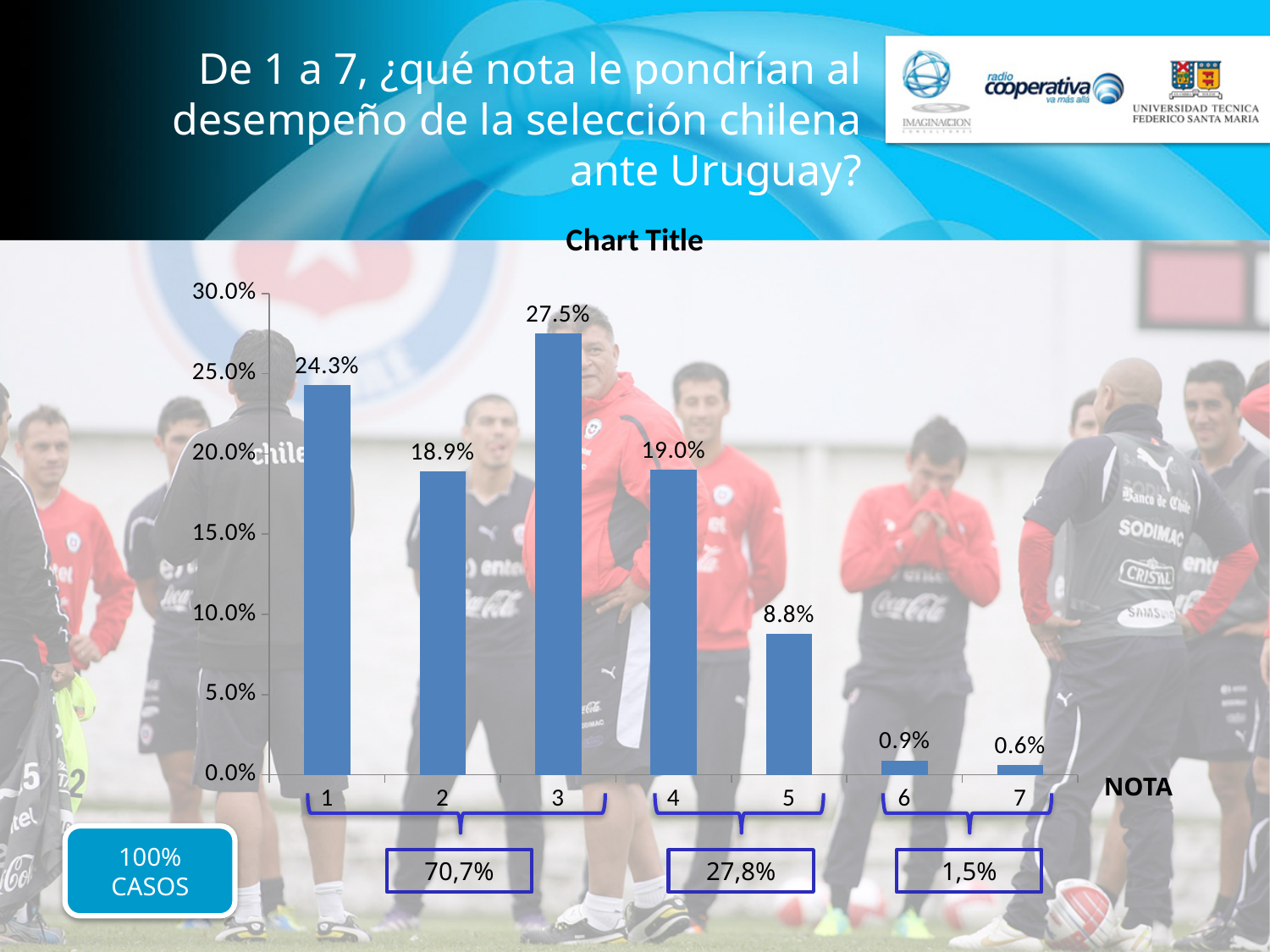
What is the value shown for nota 7? 0.6% What percentage of respondents gave a nota of 1? 24.3% What kind of chart is shown on the slide? bar chart How many nota categories are shown on the x axis? 7 What is the combined percentage shown in the box below notas 4 and 5? 27,8% Which nota has the highest percentage? 3 What is the value shown for nota 5? 8.8% What percentage of respondents gave a nota of 3? 27.5% What is the difference between the percentages for nota 3 and nota 1? 3.2% Which nota has the lowest percentage? 7 Is the value for nota 4 greater or less than 15.0%? greater Which is larger, the value for nota 2 or the value for nota 5? nota 2